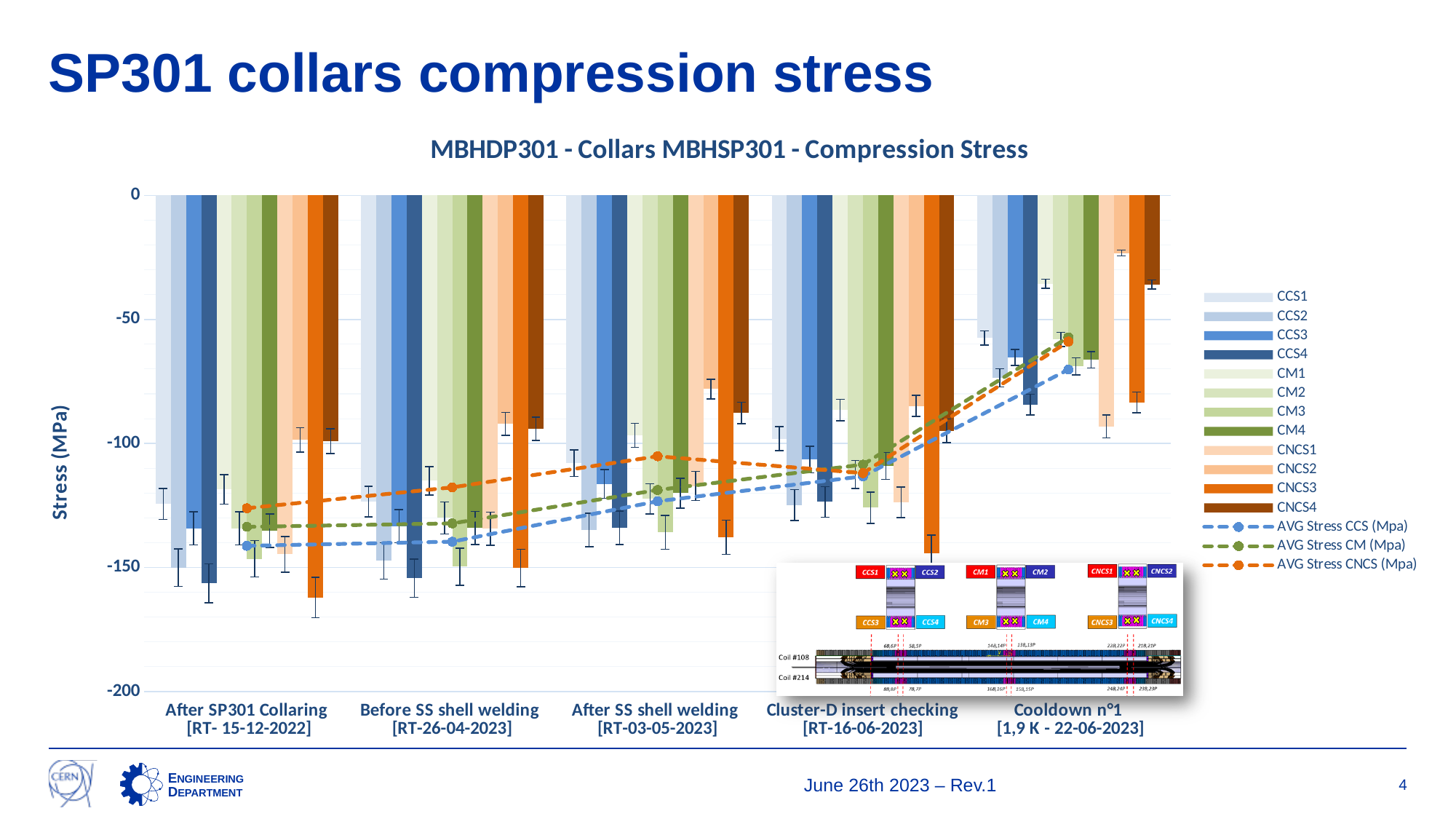
How many series does the chart's legend list? 15 What kind of chart is shown on the slide? bar and line chart Do the AVG Stress CCS values rise or fall from 'After SP301 Collaring' to 'Cooldown n°1'? rise What is the label of the vertical axis of the chart? Stress (MPa) Is the CNCS3 value at 'After SP301 Collaring' greater or less than -150? less How many categories (measurement stages) are shown along the x axis of the chart? 5 What is the title of the chart? MBHDP301 - Collars MBHSP301 - Compression Stress Is the CCS1 value at 'Cooldown n°1' greater or less than -100? greater Is the CNCS1 value at 'Cooldown n°1' greater or less than -50? less At 'After SP301 Collaring', which is higher (less negative): AVG Stress CNCS or AVG Stress CCS? AVG Stress CNCS In which category does the CNCS3 bar reach its lowest (most negative) value? After SP301 Collaring